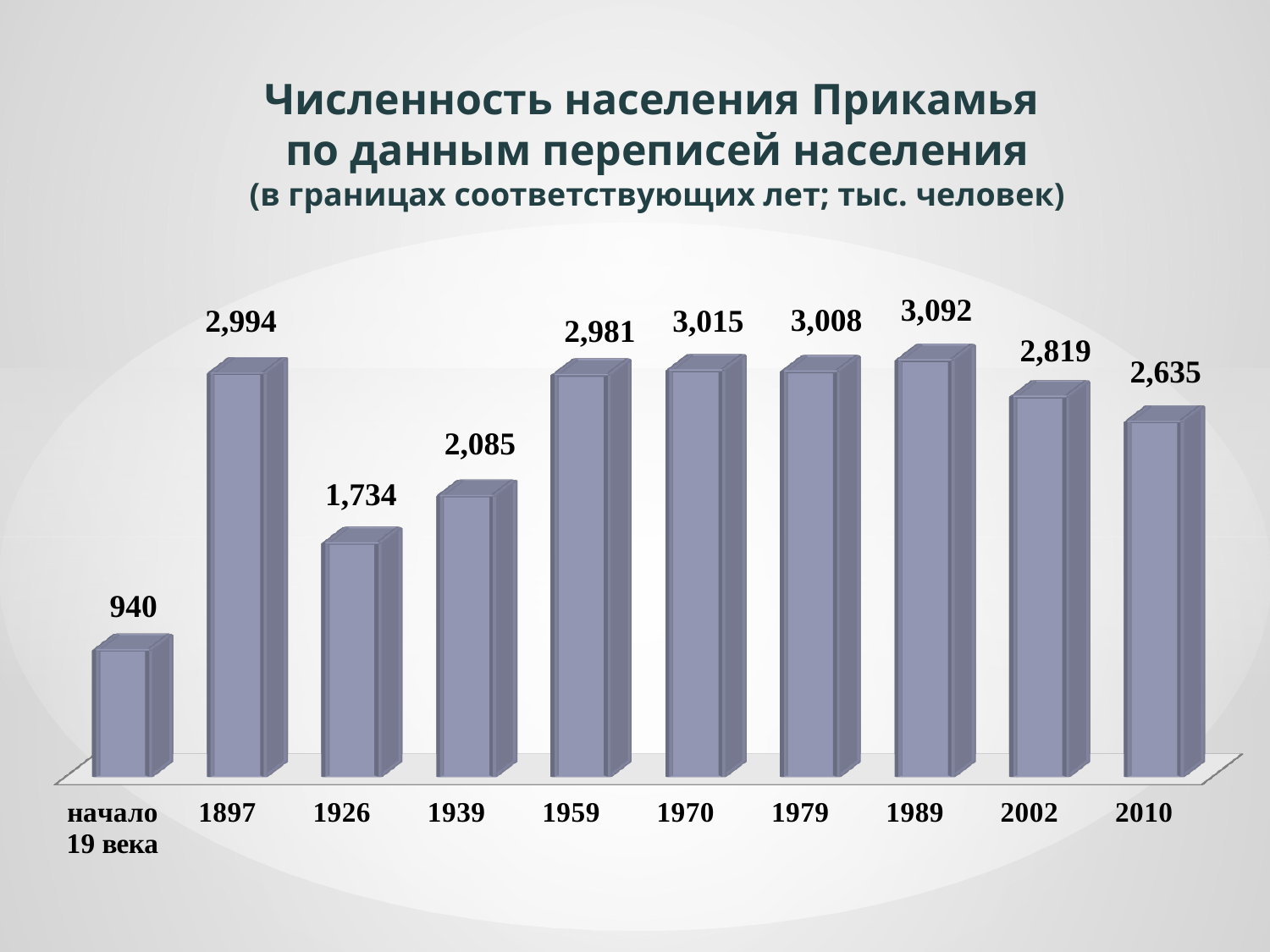
Do the values rise or fall from 1989 to 2010? fall What kind of chart is shown on the slide? bar chart Which category has the lowest population value? начало 19 века What is the population value shown for 2010? 2,635 What is the difference between the values for 1989 and 2010? 457 Which year has the highest population value? 1989 What is the difference between the values for 1939 and 1926? 351 What is the population value shown for 1897? 2,994 How many bars are shown in the chart? 10 What is the population value shown for начало 19 века? 940 What is the population value shown for 1926? 1,734 Which is larger, the value for 1897 or the value for 2002? 1897